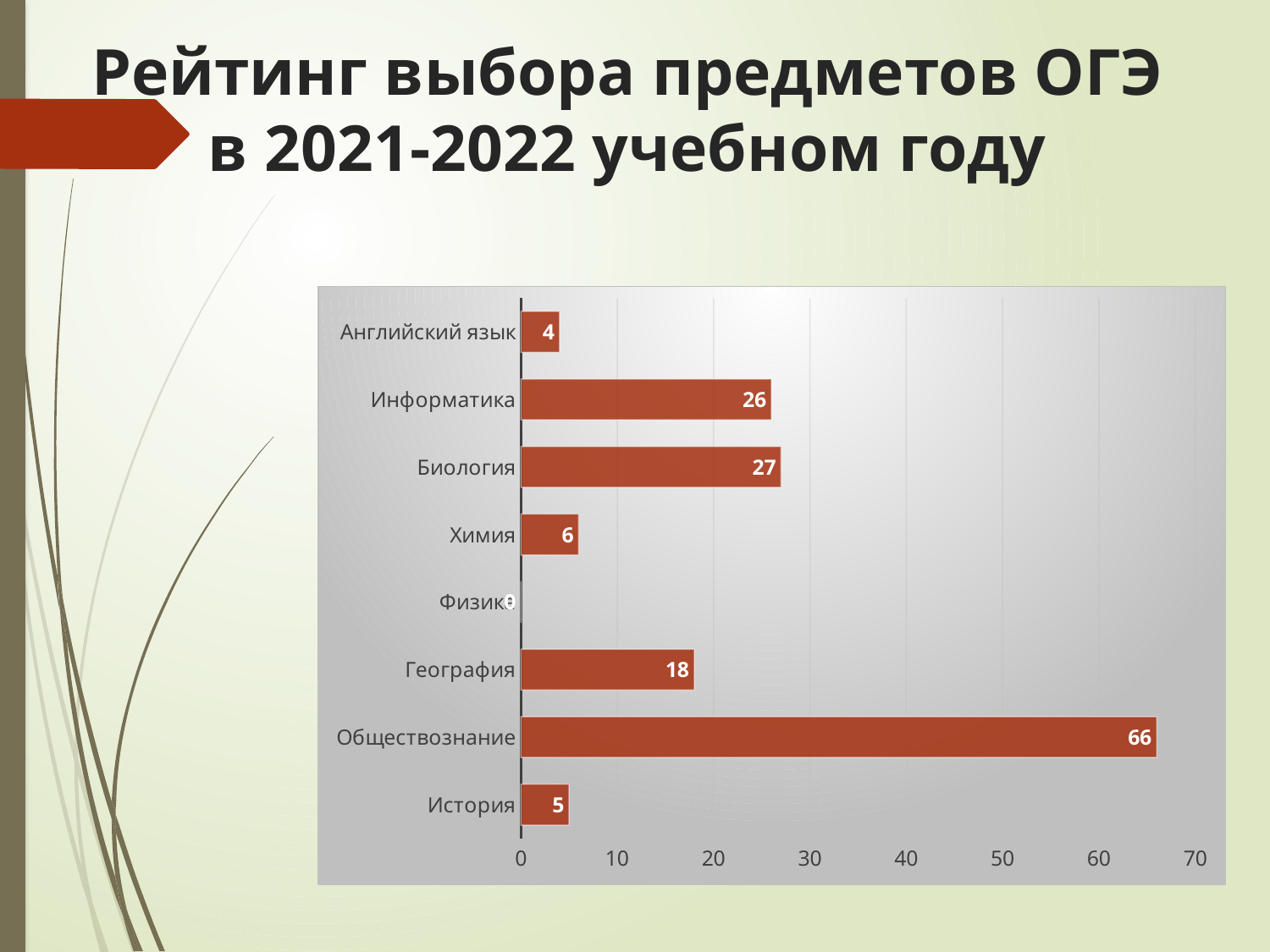
What is the value for Биология? 27 What is the value for География? 18 How many subjects are shown in the chart? 8 What is the title of the slide? Рейтинг выбора предметов ОГЭ в 2021-2022 учебном году What is the value for Английский язык? 4 What is the difference between the values for Обществознание and Биология? 39 What is the value for Обществознание? 66 Which is larger, the value for Химия or the value for История? Химия What is the difference between the values for Информатика and География? 8 Which subject has the highest value? Обществознание What kind of chart is shown on the slide? Bar chart Which subject has the lowest value? Физика